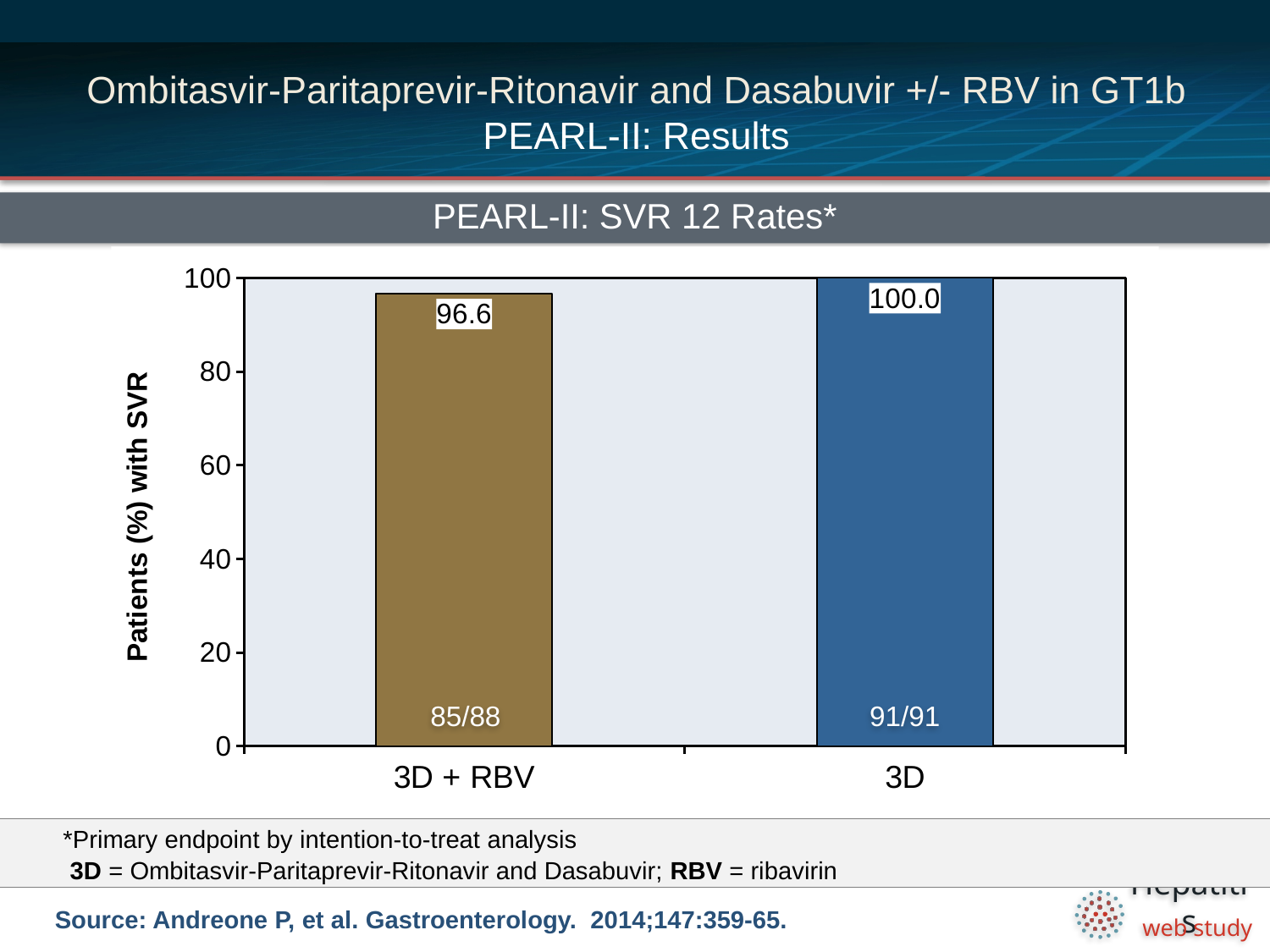
What is the SVR 12 rate for the 3D arm? 100.0 What is the title of the chart? PEARL-II: SVR 12 Rates* What fraction of patients is shown inside the 3D + RBV bar? 85/88 Which arm has the higher SVR 12 rate? 3D What type of chart is shown on the slide? bar chart What is the difference in SVR 12 rate between the 3D arm and the 3D + RBV arm? 3.4 What fraction of patients is shown inside the 3D bar? 91/91 What is the SVR 12 rate for the 3D + RBV arm? 96.6 What is the label of the y-axis? Patients (%) with SVR Is the SVR 12 rate for 3D + RBV greater or less than 80? greater How many treatment arms are shown in the chart? 2 Which arm has the lower SVR 12 rate? 3D + RBV